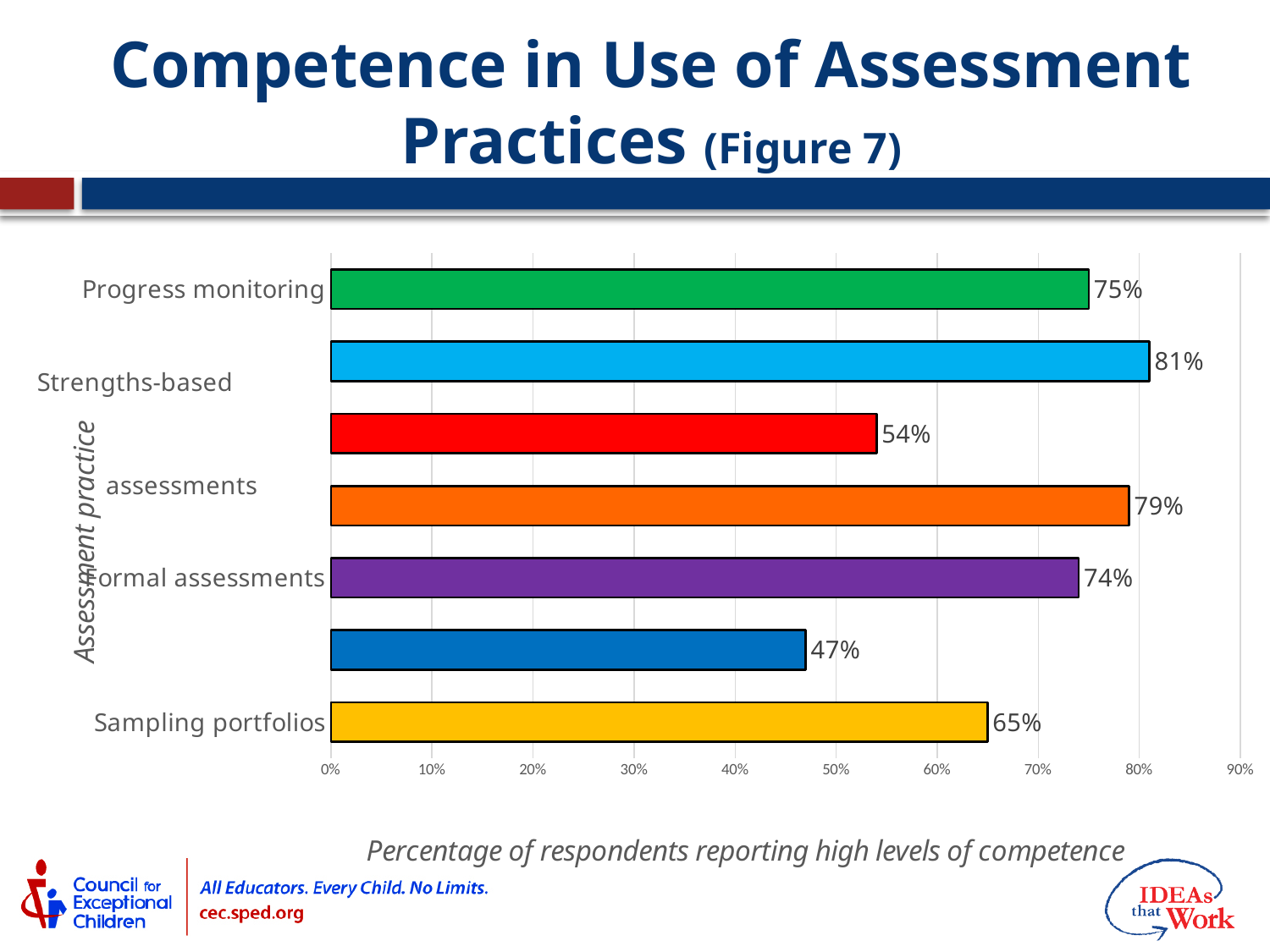
What percentage is shown for Progress monitoring? 75% What percentage is shown for Formal assessments? 74% What percentage is shown for Sampling portfolios? 65% What does the caption below the chart say the percentages represent? Percentage of respondents reporting high levels of competence How many bars are plotted on the chart? 7 Is the value for Formal assessments greater or less than 80%? less What is the difference in percentage points between Progress monitoring and Sampling portfolios? 10 percentage points What is the lowest value shown on the chart? 47% Which has a higher value, Progress monitoring or Sampling portfolios? Progress monitoring What is the title of the vertical axis? Assessment practice What is the highest value shown on the chart? 81% What type of chart is shown on the slide? Bar chart